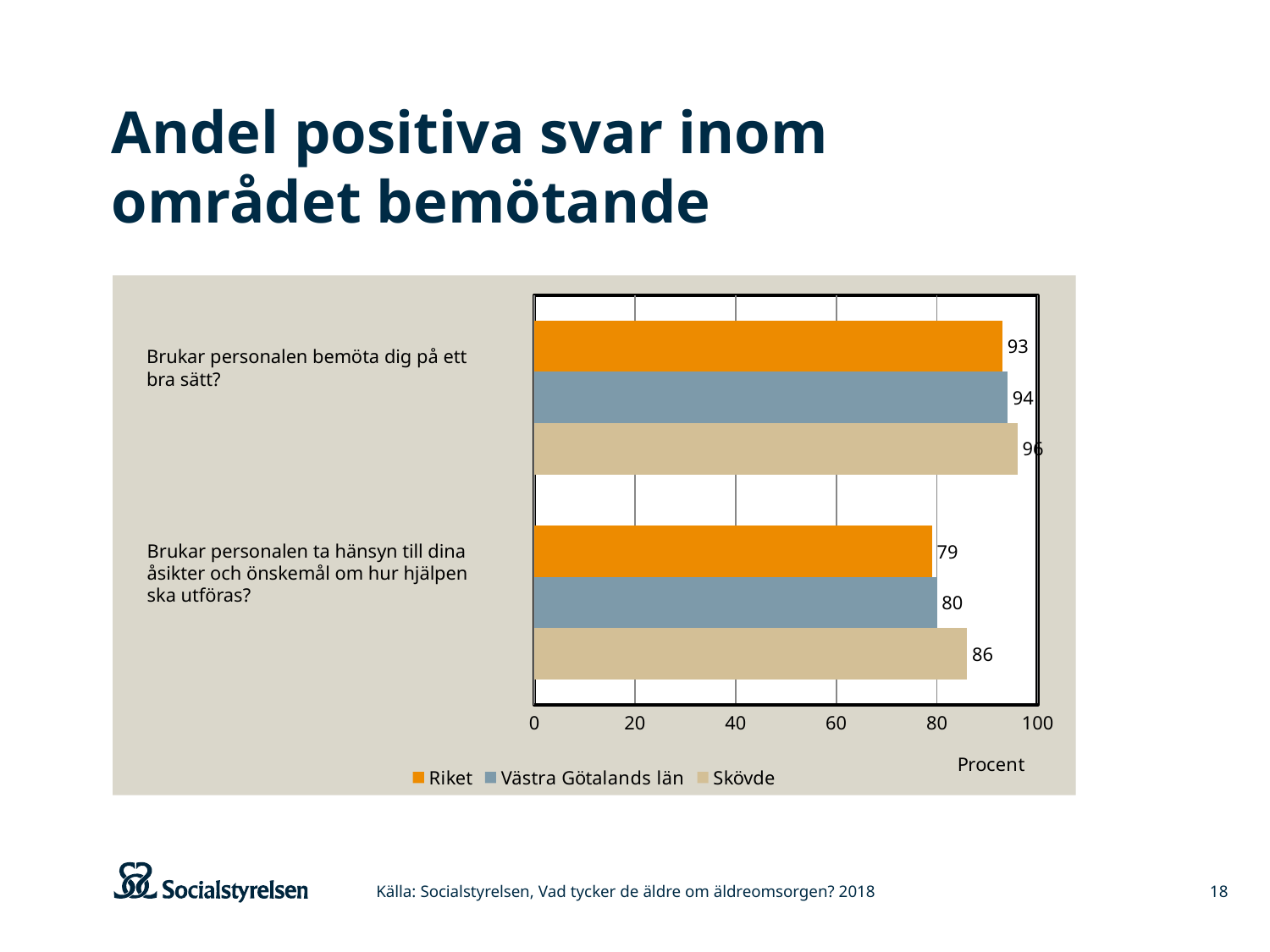
What is the value for Västra Götalands län for the question "Brukar personalen bemöta dig på ett bra sätt?"? 94 Which series has the lowest value for the question "Brukar personalen bemöta dig på ett bra sätt?"? Riket What is the value for Riket for the question "Brukar personalen bemöta dig på ett bra sätt?"? 93 What is the label on the horizontal axis of the chart? Procent What kind of chart is shown on the slide? bar chart Which is larger for Skövde: the value for "Brukar personalen bemöta dig på ett bra sätt?" or for "Brukar personalen ta hänsyn till dina åsikter och önskemål om hur hjälpen ska utföras?"? Brukar personalen bemöta dig på ett bra sätt? Is the value for Västra Götalands län for the question "Brukar personalen ta hänsyn till dina åsikter och önskemål om hur hjälpen ska utföras?" greater or less than 60? greater What is the value for Skövde for the question "Brukar personalen ta hänsyn till dina åsikter och önskemål om hur hjälpen ska utföras?"? 86 What is the difference between Skövde and Riket for the question "Brukar personalen ta hänsyn till dina åsikter och önskemål om hur hjälpen ska utföras?"? 7 Which series has the highest value for the question "Brukar personalen ta hänsyn till dina åsikter och önskemål om hur hjälpen ska utföras?"? Skövde How many series does the legend list? 3 What is the value for Riket for the question "Brukar personalen ta hänsyn till dina åsikter och önskemål om hur hjälpen ska utföras?"? 79